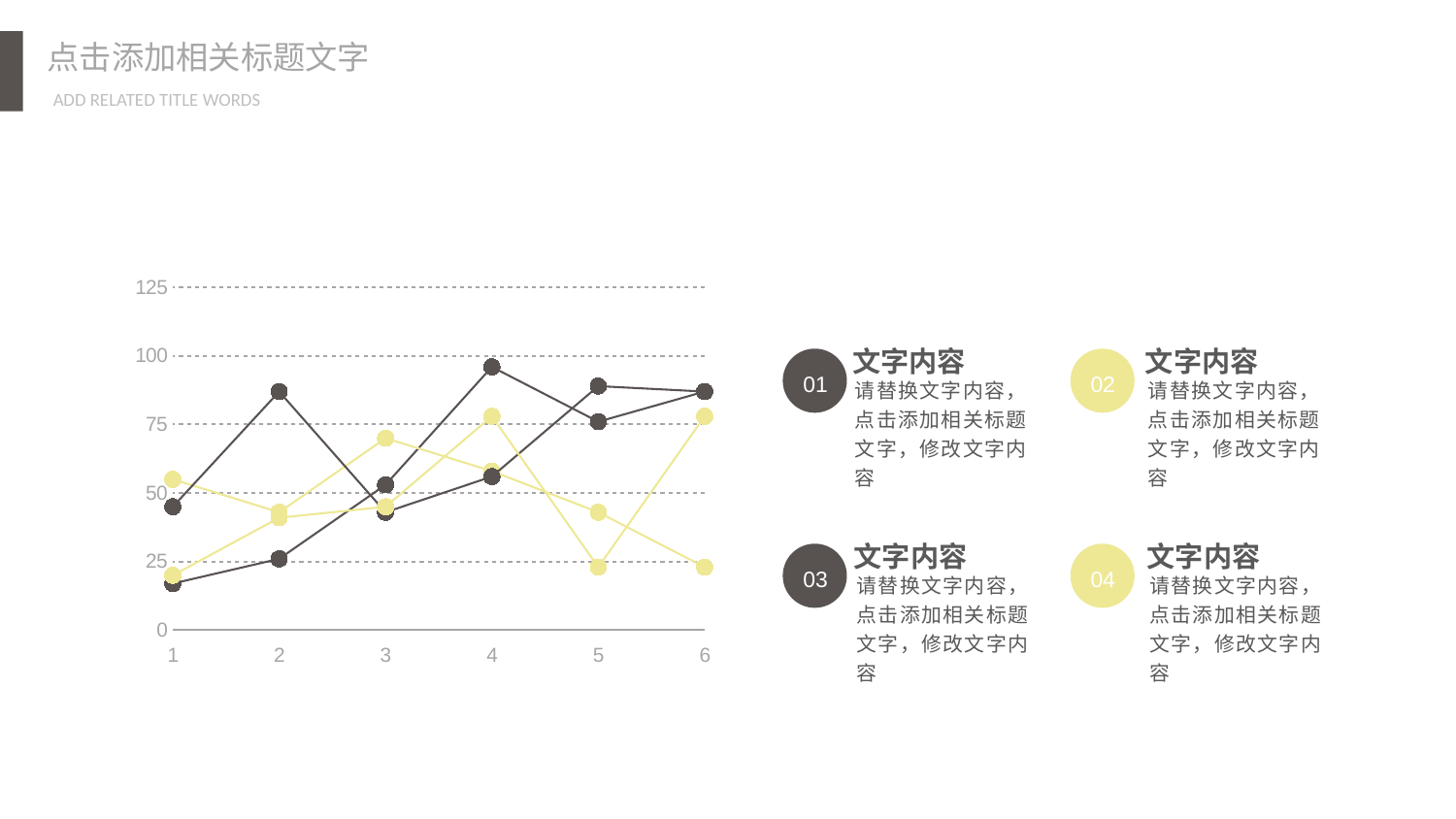
How many points are labelled along the x axis of the chart? 6 Is the highest plotted value at x = 2 greater or less than 75? greater Is the highest plotted value at x = 5 greater or less than 75? greater Is the lowest plotted value at x = 1 greater or less than 25? less What is the highest value labelled on the y axis of the chart? 125 At which x-axis point does the chart reach its highest plotted value? 4 What kind of chart is shown on the slide? line chart How many lines are plotted on the chart? 4 What is the lowest value labelled on the y axis of the chart? 0